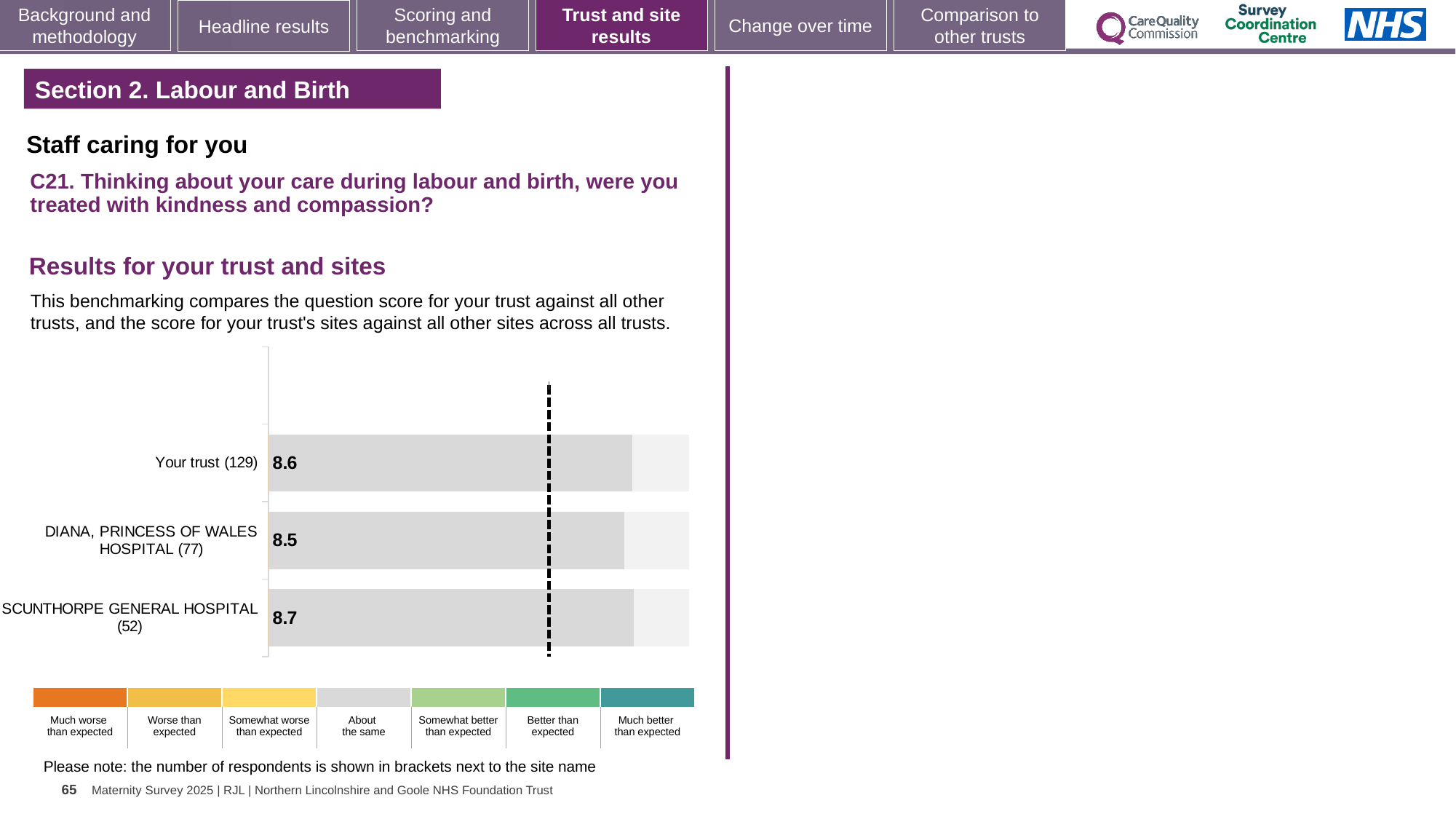
How many respondents are shown in brackets for Your trust? 129 Which site or trust has the lowest score on the chart? Diana, Princess of Wales Hospital What is the score for Your trust? 8.6 How many colour bands does the legend below the chart show? 7 Which has the larger score, Your trust or Scunthorpe General Hospital? Scunthorpe General Hospital What is the difference between the scores for Your trust and Diana, Princess of Wales Hospital? 0.1 What is the score for Diana, Princess of Wales Hospital? 8.5 What is the difference between the scores for Scunthorpe General Hospital and Diana, Princess of Wales Hospital? 0.2 What is the score for Scunthorpe General Hospital? 8.7 How many bars are shown on the chart? 3 What kind of chart is shown on the slide? Bar chart Which site or trust has the highest score on the chart? Scunthorpe General Hospital